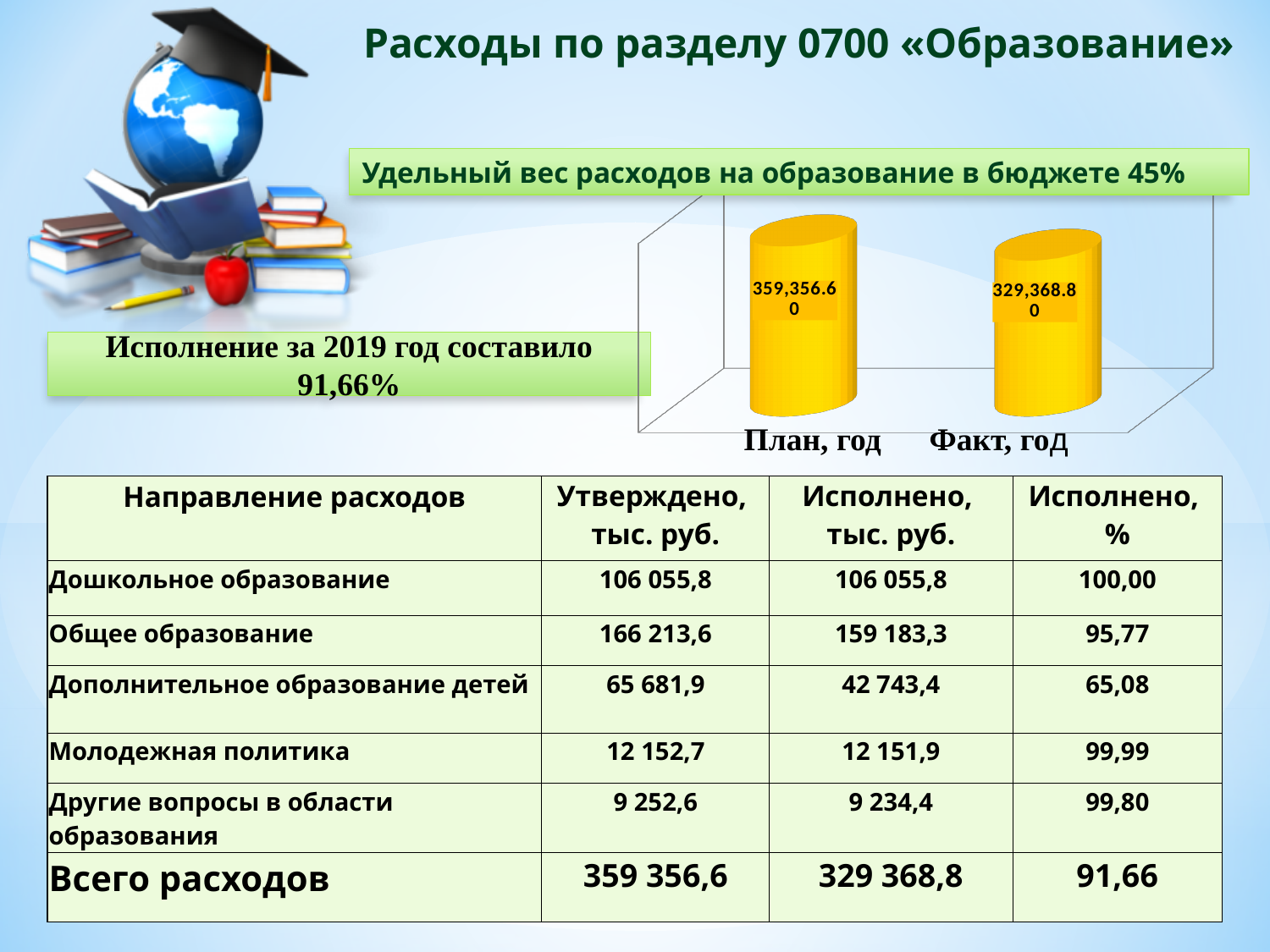
Is the value for «План, год» larger or smaller than the value for «Факт, год»? larger What is the difference between the «План, год» value and the «Факт, год» value in the chart? 29,987.80 Which category in the chart has the lower value? Факт, год Do the values rise or fall from «План, год» to «Факт, год»? fall Which category in the chart has the higher value? План, год What value is shown for «План, год» in the chart? 359,356.60 What type of chart is shown on the slide? bar chart How many bars are plotted in the chart? 2 What value is shown for «Факт, год» in the chart? 329,368.80 What are the two category labels on the chart's x axis? План, год; Факт, год What colour are the bars in the chart? yellow